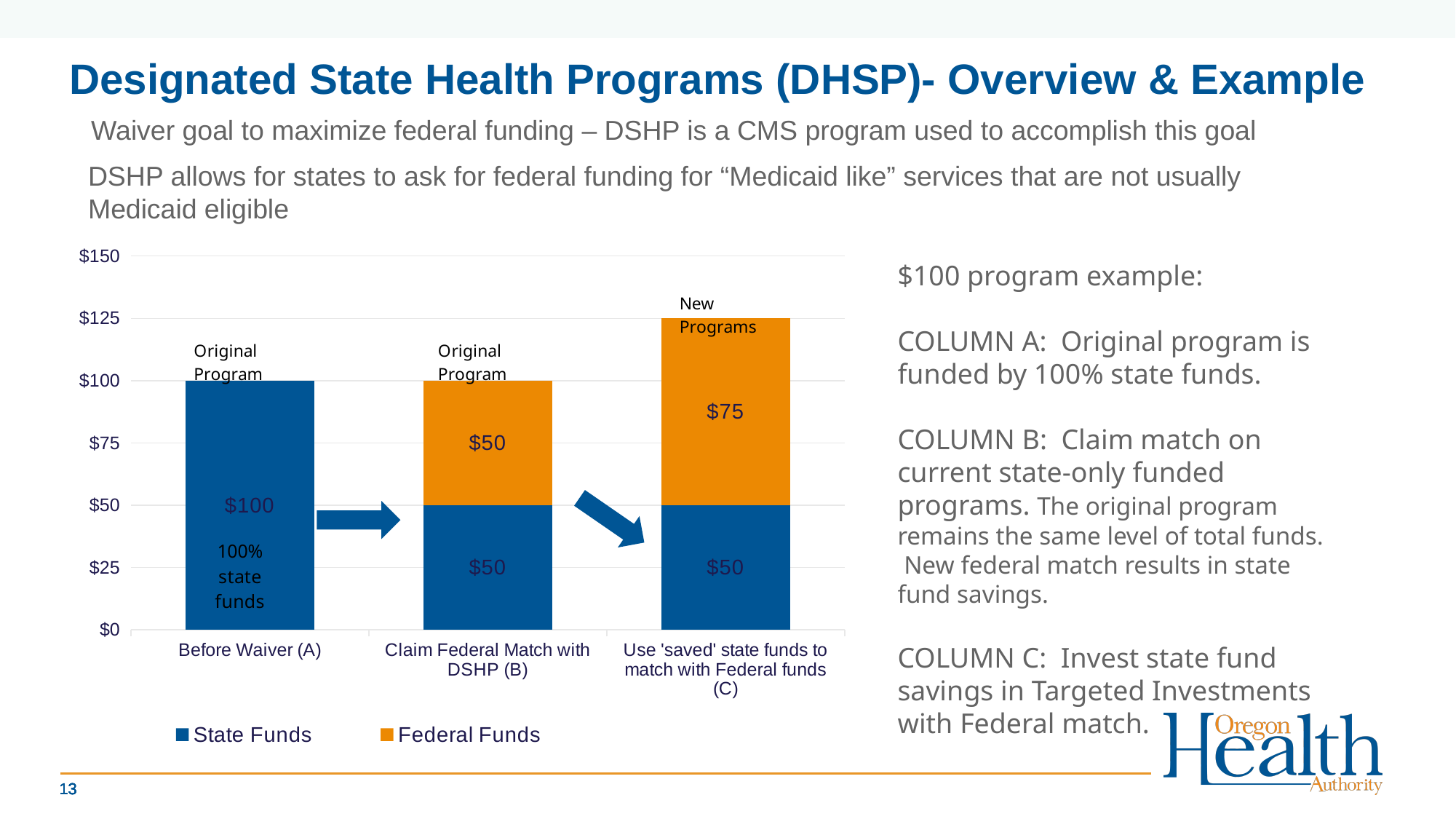
Which category has the highest Federal Funds value? Use 'saved' state funds to match with Federal funds (C) What is the difference between the Federal Funds values for column C and column B? $25 What is the State Funds value for Before Waiver (A)? $100 How many categories are shown on the x axis of the chart? 3 What is the total of the stacked bar for Use 'saved' state funds to match with Federal funds (C)? $125 How many series does the chart legend list? 2 Which series is shown in orange in the chart legend? Federal Funds What is the total of the stacked bar for Claim Federal Match with DSHP (B)? $100 What kind of chart is shown on the slide? Stacked bar chart What is the Federal Funds value for Use 'saved' state funds to match with Federal funds (C)? $75 What is the Federal Funds value for Claim Federal Match with DSHP (B)? $50 What is the State Funds value for Use 'saved' state funds to match with Federal funds (C)? $50